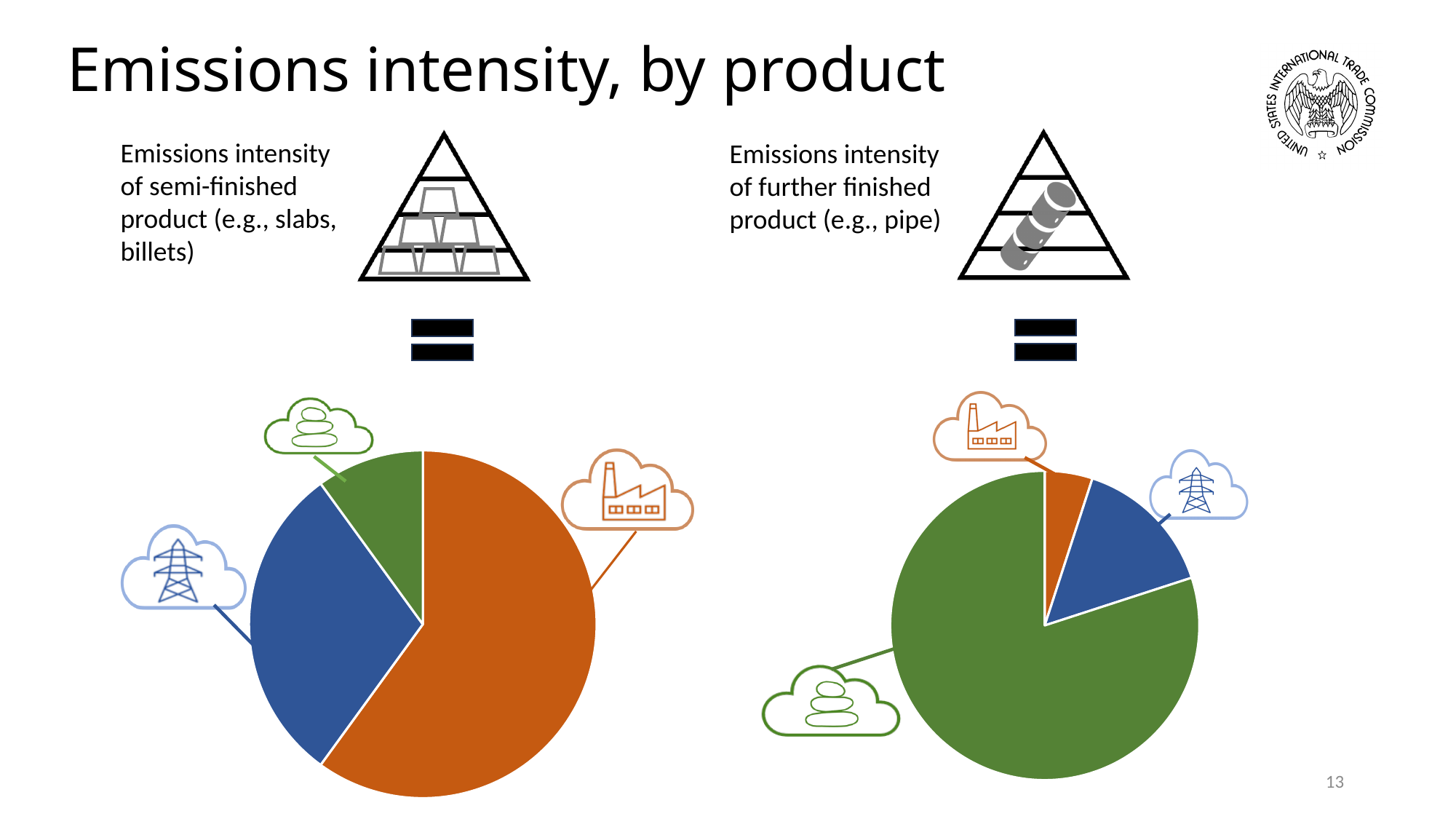
How many slices does the left pie chart have? 3 How many slices does the right pie chart have? 3 In the left pie chart, which icon is connected to the orange slice? factory What kind of chart is the left chart on the slide? pie chart In the right pie chart, which colour slice is the smallest? orange In the left pie chart, which colour slice is the smallest? green What kind of chart is the right chart on the slide? pie chart In the right pie chart, which is larger, the blue slice or the orange slice? blue What is the title of the slide? Emissions intensity, by product In the left pie chart, which is larger, the blue slice or the green slice? blue In the left pie chart, which colour slice is the largest? orange In the right pie chart, which colour slice is the largest? green